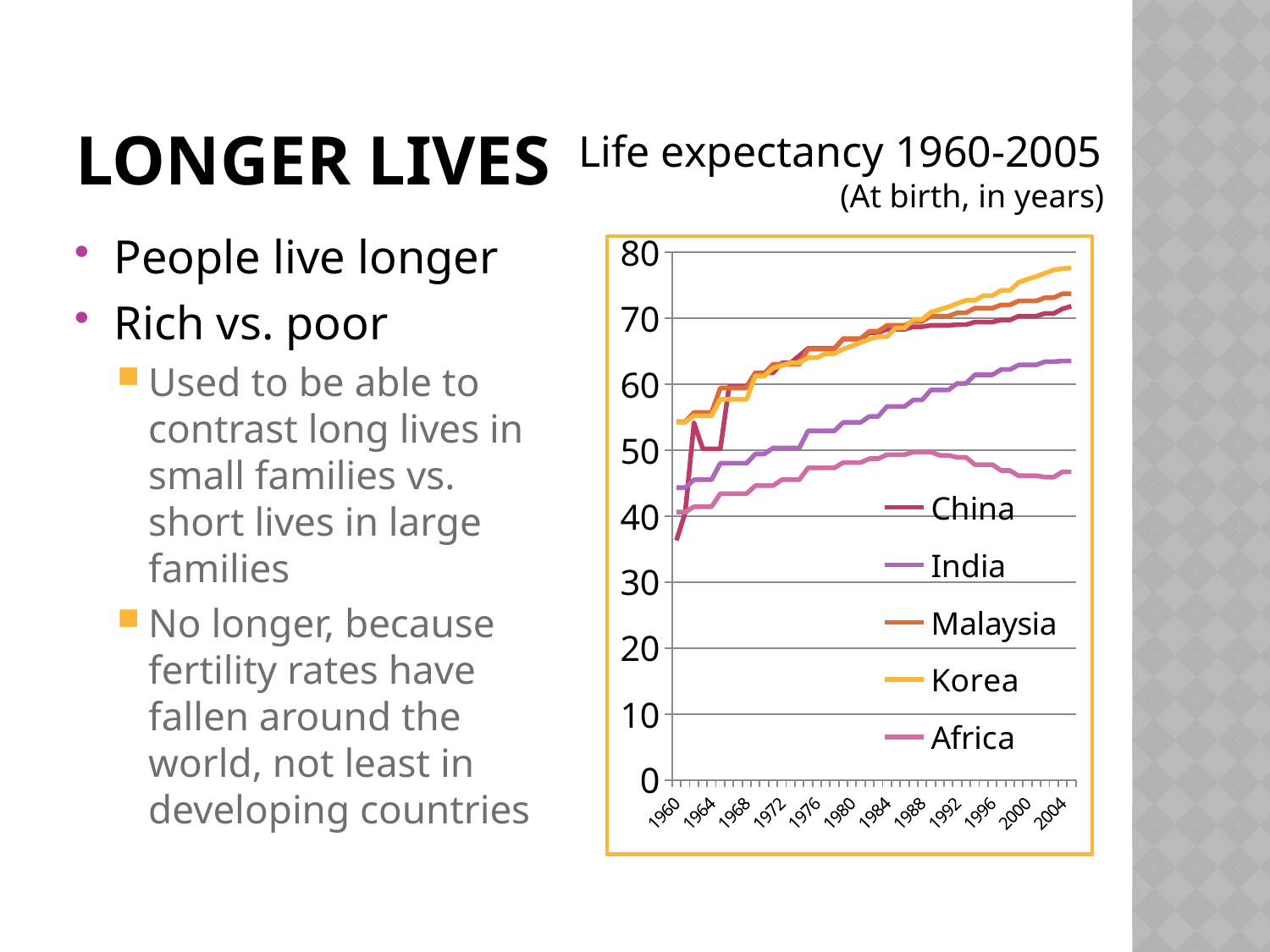
What kind of chart is shown on the slide? line chart Is the value for Africa in 2004 greater or less than 50? less What is the title of the chart? Life expectancy 1960-2005 Does the value for Africa rise or fall between 1992 and 2004? fall Which series has the highest value in 2004? Korea How many series does the chart's legend list? 5 In 2004, which is higher: Korea or India? Korea Is the value for Malaysia in 2004 greater or less than 70? greater Which series are listed in the chart's legend? China, India, Malaysia, Korea, Africa Which series has the lowest value in 2004? Africa Is the value for India in 1960 greater or less than 50? less